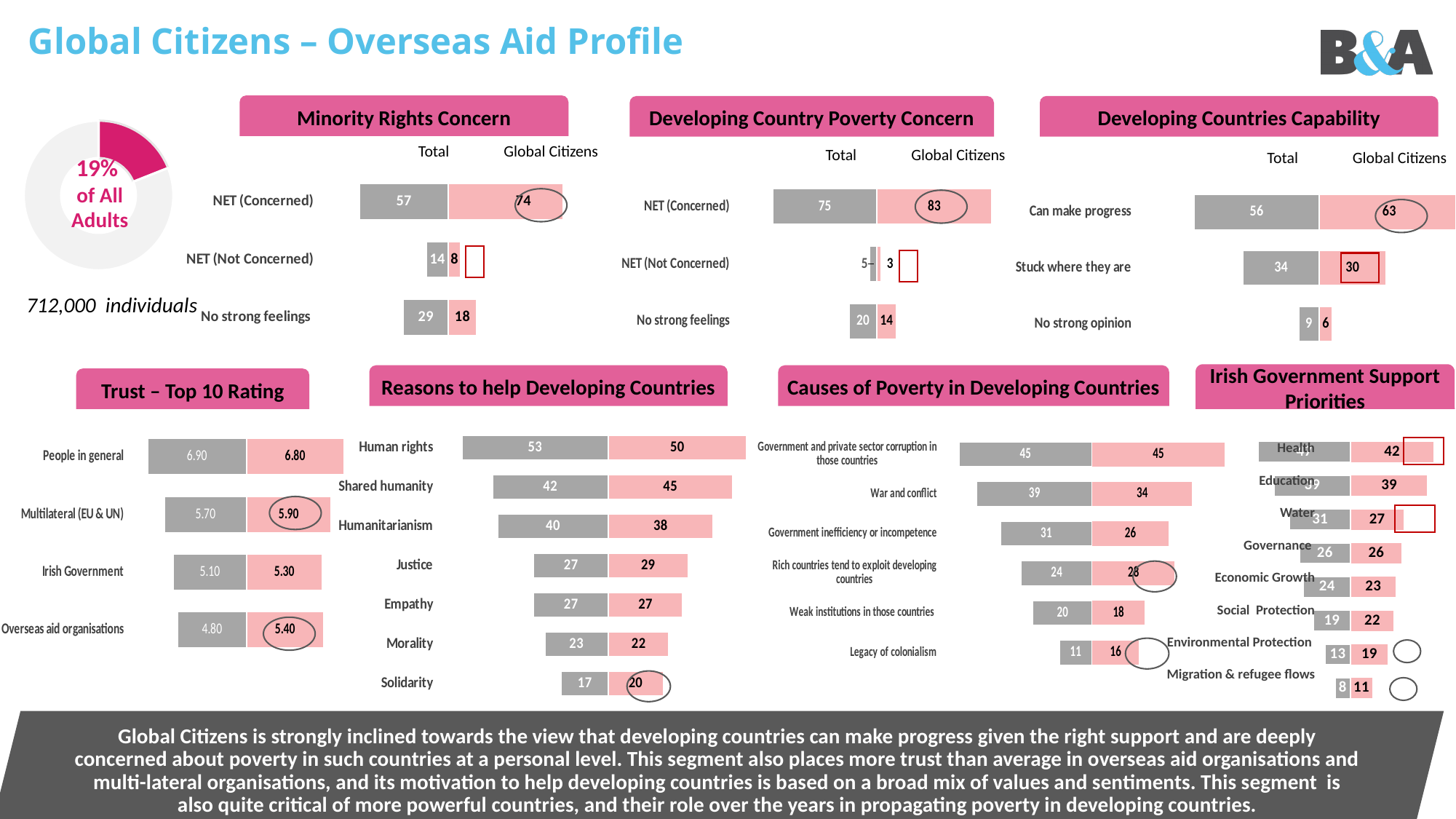
In the Reasons to help Developing Countries chart, which reason has the lowest Total value? Solidarity In the Minority Rights Concern chart, what is the Global Citizens value for NET (Concerned)? 74 In the Irish Government Support Priorities chart, what is the Global Citizens value for Environmental Protection? 19 In the Causes of Poverty in Developing Countries chart, what is the difference between the Total and Global Citizens values for War and conflict? 5 In the Reasons to help Developing Countries chart, which reason has the highest Global Citizens value? Human rights In the Developing Country Poverty Concern chart, what is the Total value for NET (Concerned)? 75 In the Developing Countries Capability chart, what is the difference between the Global Citizens and Total values for Can make progress? 7 In the Causes of Poverty in Developing Countries chart, what is the Global Citizens value for Legacy of colonialism? 16 In the Trust – Top 10 Rating chart, what is the Global Citizens rating for Overseas aid organisations? 5.40 In the Trust – Top 10 Rating chart, which is larger for Multilateral (EU & UN): the Total or the Global Citizens rating? Global Citizens What percentage of all adults does the donut chart show Global Citizens represent? 19% How many reasons are listed in the Reasons to help Developing Countries chart? 7